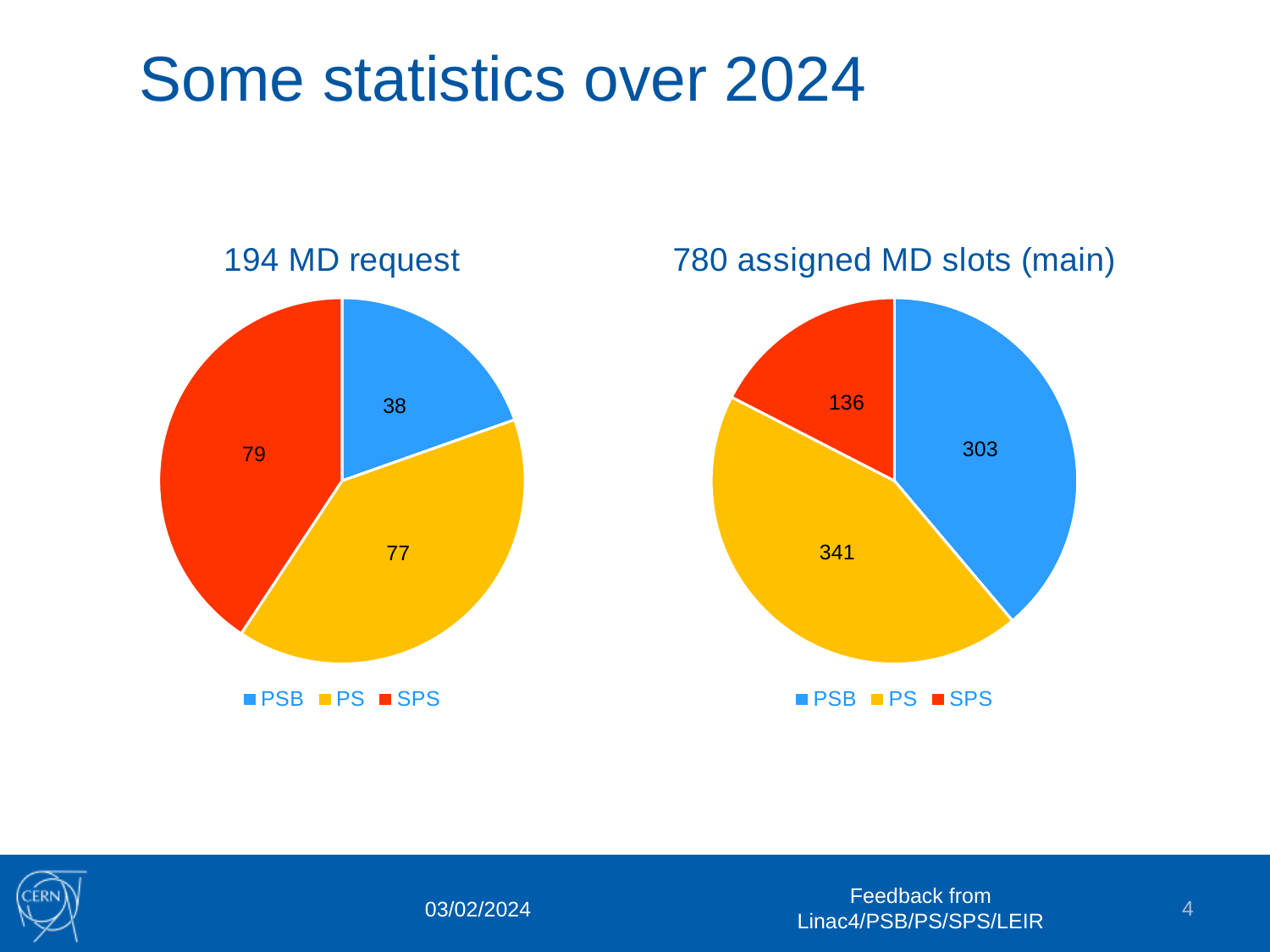
In the '780 assigned MD slots (main)' chart, which category has the largest slice? PS In the '780 assigned MD slots (main)' chart, what is the value for PS? 341 In the '194 MD request' chart, which category has the smallest slice? PSB In the '780 assigned MD slots (main)' chart, what is the difference between the PS and PSB values? 38 In the '780 assigned MD slots (main)' chart, which category has the smallest slice? SPS In the '194 MD request' chart, is the value for SPS larger or smaller than the value for PSB? larger How many categories does the legend of the '780 assigned MD slots (main)' chart list? 3 In the '194 MD request' chart, what colour is the PS slice? yellow In the '780 assigned MD slots (main)' chart, what is the value for SPS? 136 In the '194 MD request' chart, what is the value for PS? 77 What kind of chart is the '194 MD request' chart? pie chart In the '194 MD request' chart, what is the value for PSB? 38